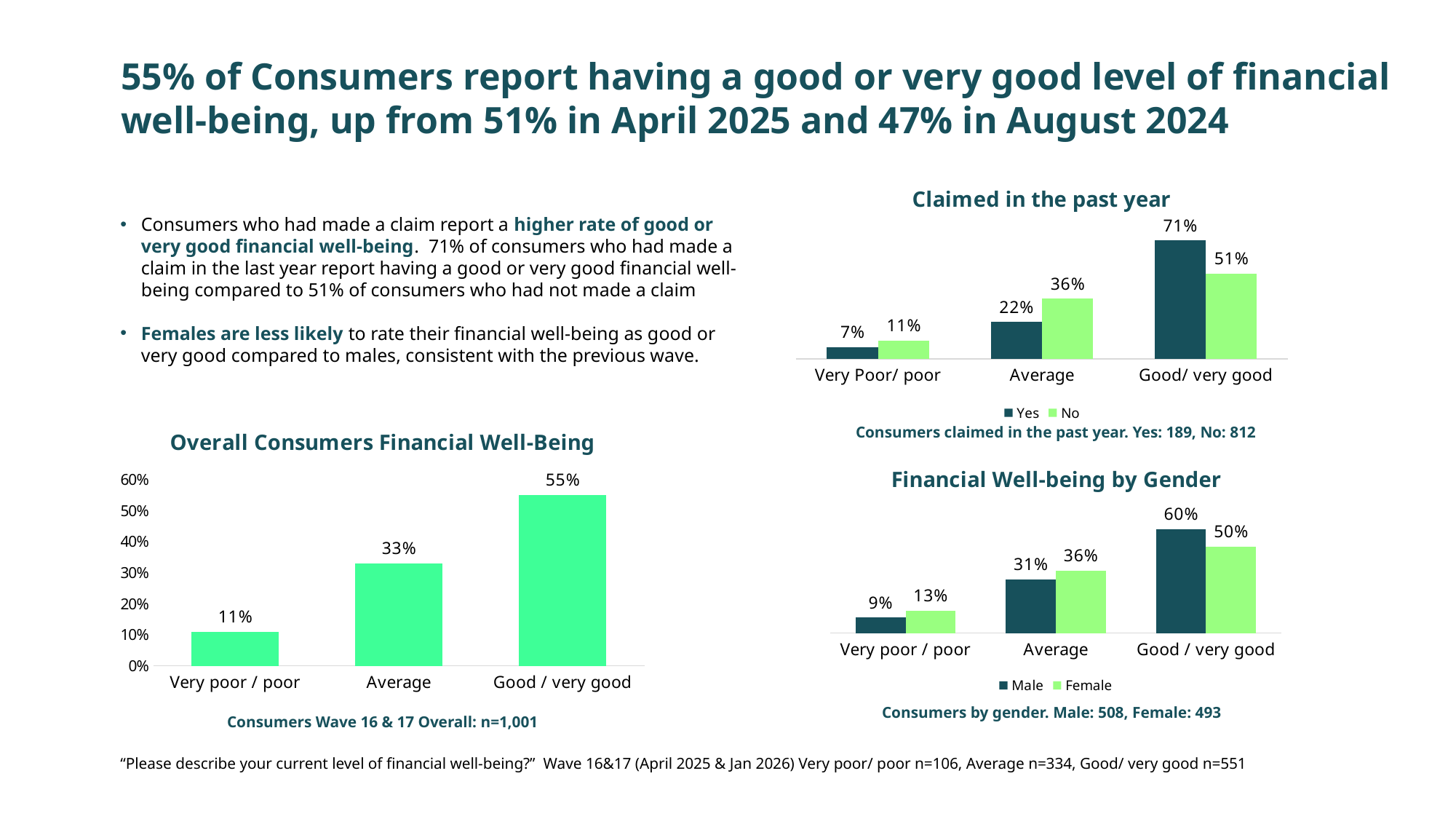
What kind of chart is 'Financial Well-being by Gender'? Bar chart In the 'Financial Well-being by Gender' chart, what is the Female value for Good / very good? 50% In the 'Overall Consumers Financial Well-Being' chart, what is the value for Average? 33% In the 'Overall Consumers Financial Well-Being' chart, what is the difference between Good / very good and Very poor / poor? 44% In the 'Claimed in the past year' chart, what is the Yes value for Good/ very good? 71% In the 'Overall Consumers Financial Well-Being' chart, which category has the highest value? Good / very good In the 'Claimed in the past year' chart, how many series does the legend list? 2 In the 'Financial Well-being by Gender' chart, which category has the lowest Male value? Very poor / poor In the 'Overall Consumers Financial Well-Being' chart, how many categories are shown? 3 In the 'Financial Well-being by Gender' chart, what is the difference between Male and Female for Good / very good? 10% In the 'Claimed in the past year' chart, which is larger for Very Poor/ poor: Yes or No? No In the 'Claimed in the past year' chart, what is the No value for Average? 36%